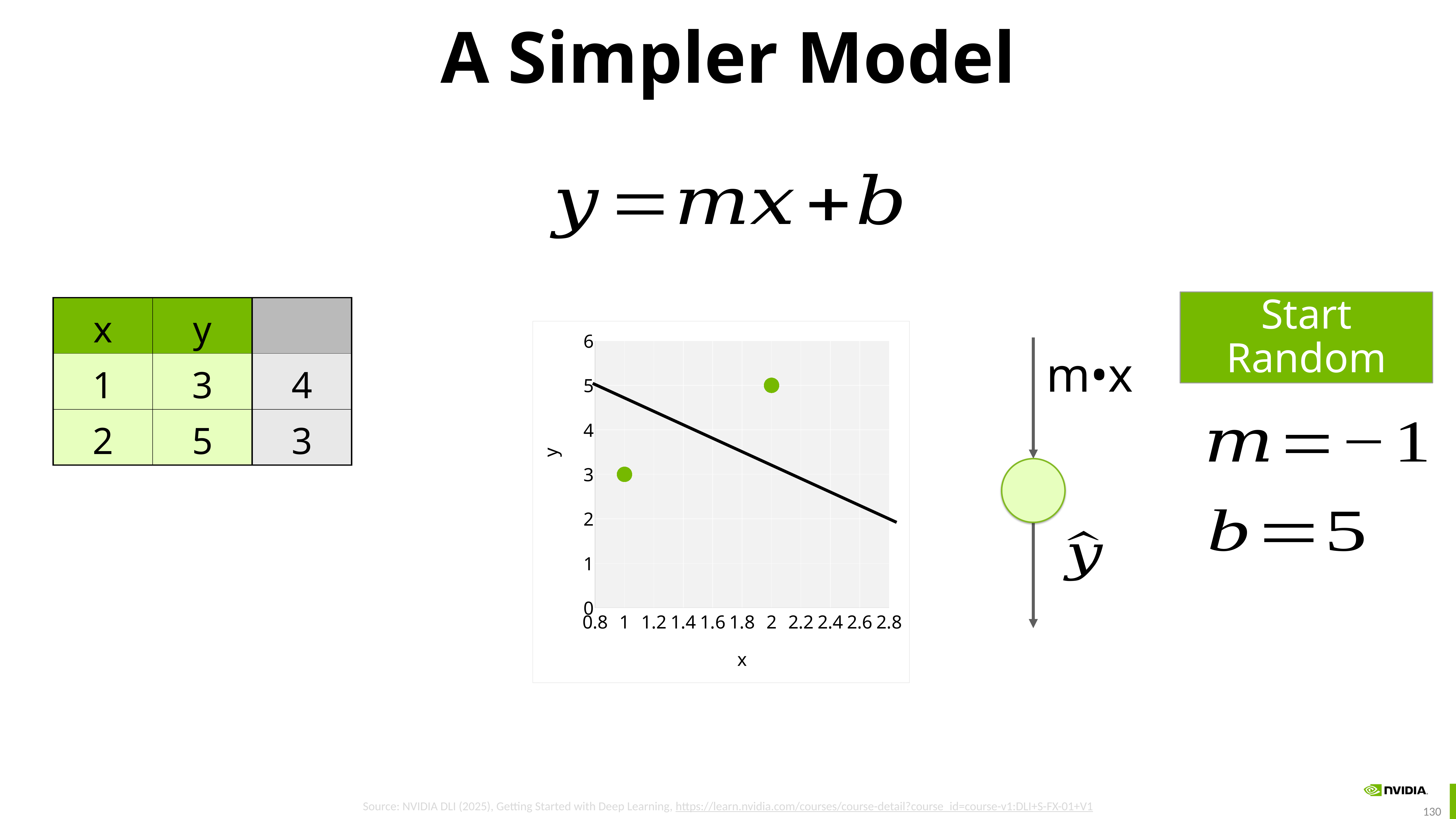
What is the difference between the y values of the points at x = 2 and x = 1? 2 What kind of chart is shown on the slide? scatter chart At which x value does the plotted point have the highest y value? 2 How many data points are plotted in the chart? 2 Is the value of the black line at x = 1 greater or less than 4? greater What is the highest tick value shown on the y axis of the chart? 6 Is the value of the black line at x = 2.8 greater or less than 3? less Which plotted point has the larger y value, the one at x = 1 or the one at x = 2? x = 2 Do the plotted points rise or fall as x increases? rise What is the y value of the plotted point at x = 1? 3 At which x value does the plotted point have the lowest y value? 1 What is the y value of the plotted point at x = 2? 5